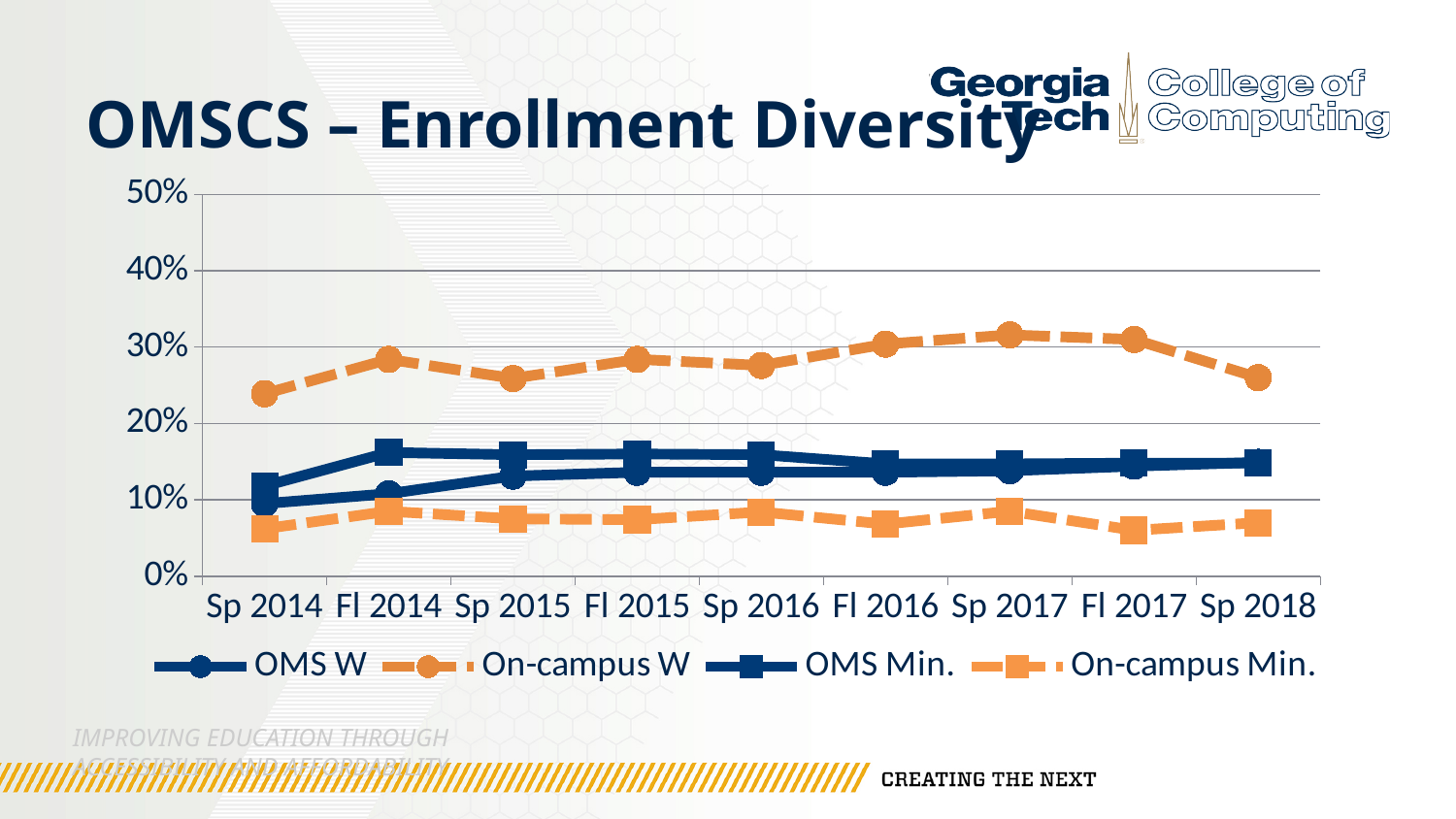
Is the value for OMS W at Fl 2014 greater or less than 20%? less Which series are listed in the legend? OMS W, On-campus W, OMS Min., On-campus Min. At Sp 2018, which is larger: On-campus W or OMS W? On-campus W Does the OMS W series rise or fall from Sp 2014 to Fl 2015? rise At Fl 2017, which is larger: OMS Min. or On-campus Min.? OMS Min. How many series does the legend list? 4 What kind of chart is shown on the slide? line chart Is the value for OMS Min. at Fl 2014 greater or less than 10%? greater Is the value for On-campus Min. at Sp 2014 greater or less than 10%? less What is the title of the slide's chart? OMSCS – Enrollment Diversity How many time periods are shown on the x axis? 9